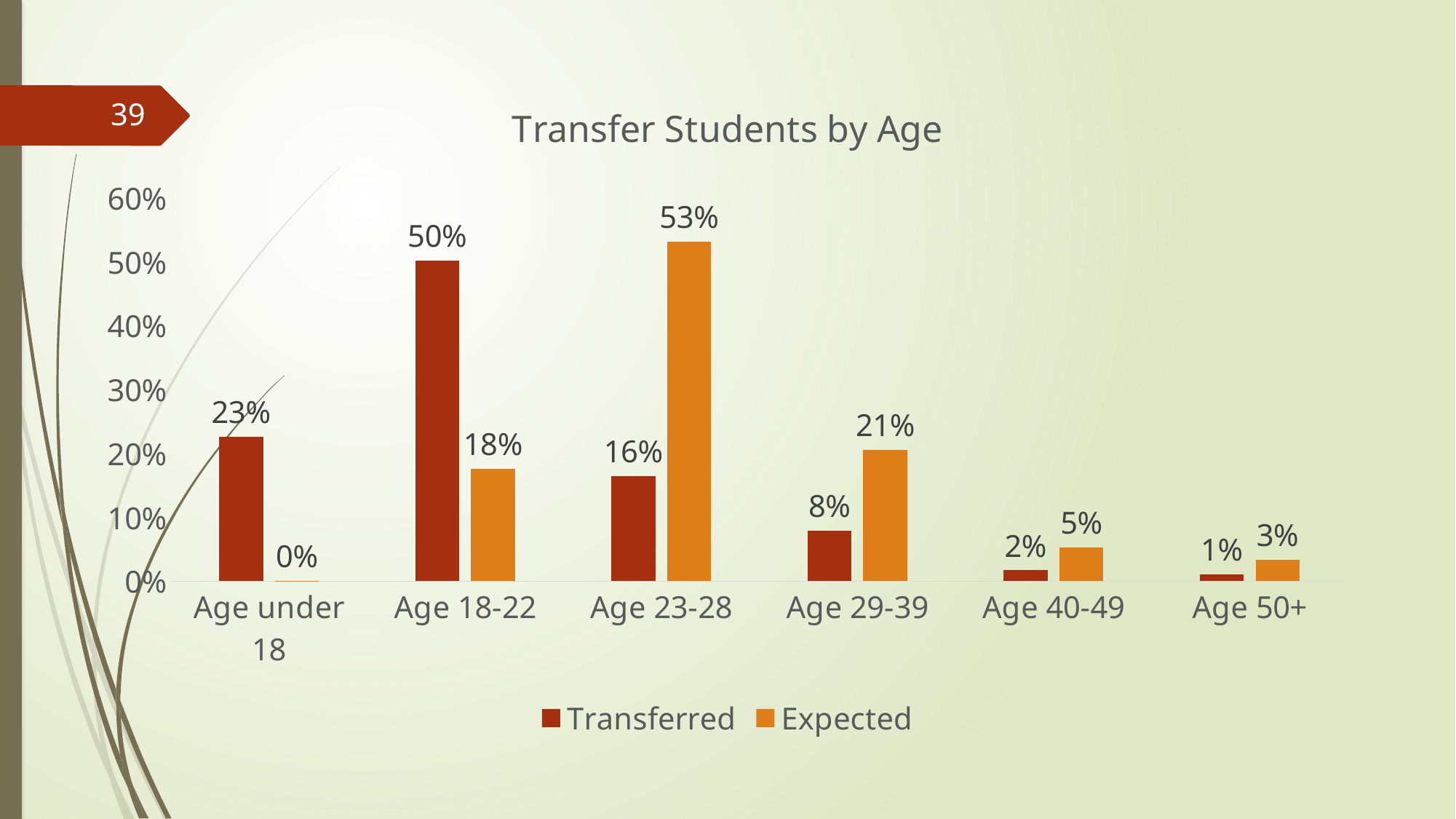
What is the difference between the Expected and Transferred values for Age 23-28? 37% What is the Expected value for Age under 18? 0% For Age 29-39, which is larger: Transferred or Expected? Expected How many age groups are shown on the x axis? 6 Which age group has the lowest Expected value? Age under 18 What kind of chart is shown on the slide? Bar chart What is the Expected value for Age 23-28? 53% Which age group has the highest Transferred value? Age 18-22 What is the title of the chart? Transfer Students by Age What is the Transferred value for Age 18-22? 50% How many series does the legend list? 2 What is the Transferred value for Age 50+? 1%